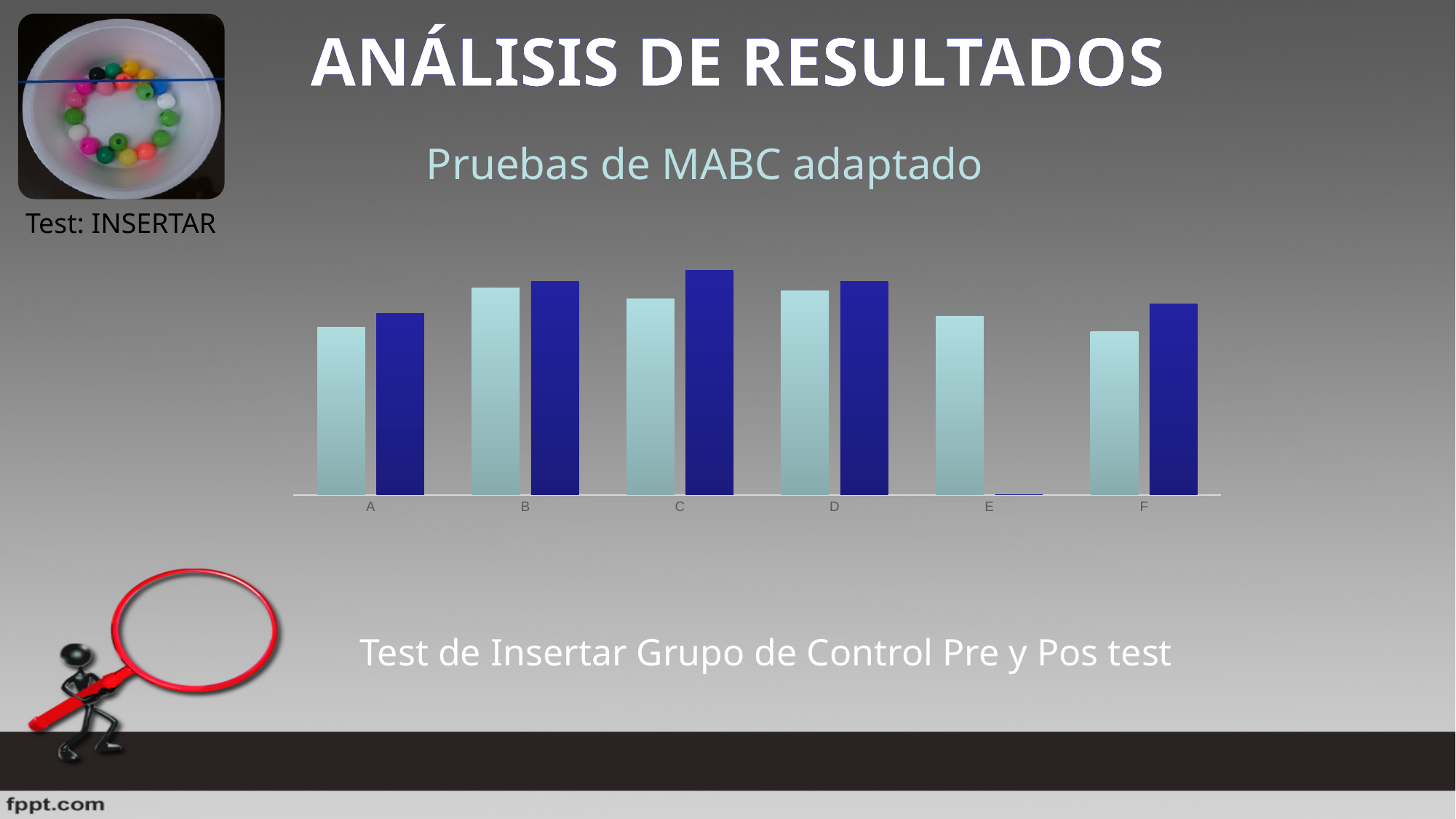
Which category has the shortest dark blue bar? E Which category has the tallest dark blue bar? C How many categories are shown along the x axis of the chart? 6 Is the dark blue bar for category F taller or shorter than the dark blue bar for category B? shorter In category E, which bar is taller, the light blue one or the dark blue one? the light blue one In category A, which bar is taller, the light blue one or the dark blue one? the dark blue one What kind of chart is shown on the slide? bar chart What is the subtitle shown above the chart? Pruebas de MABC adaptado What is the caption written below the chart? Test de Insertar Grupo de Control Pre y Pos test